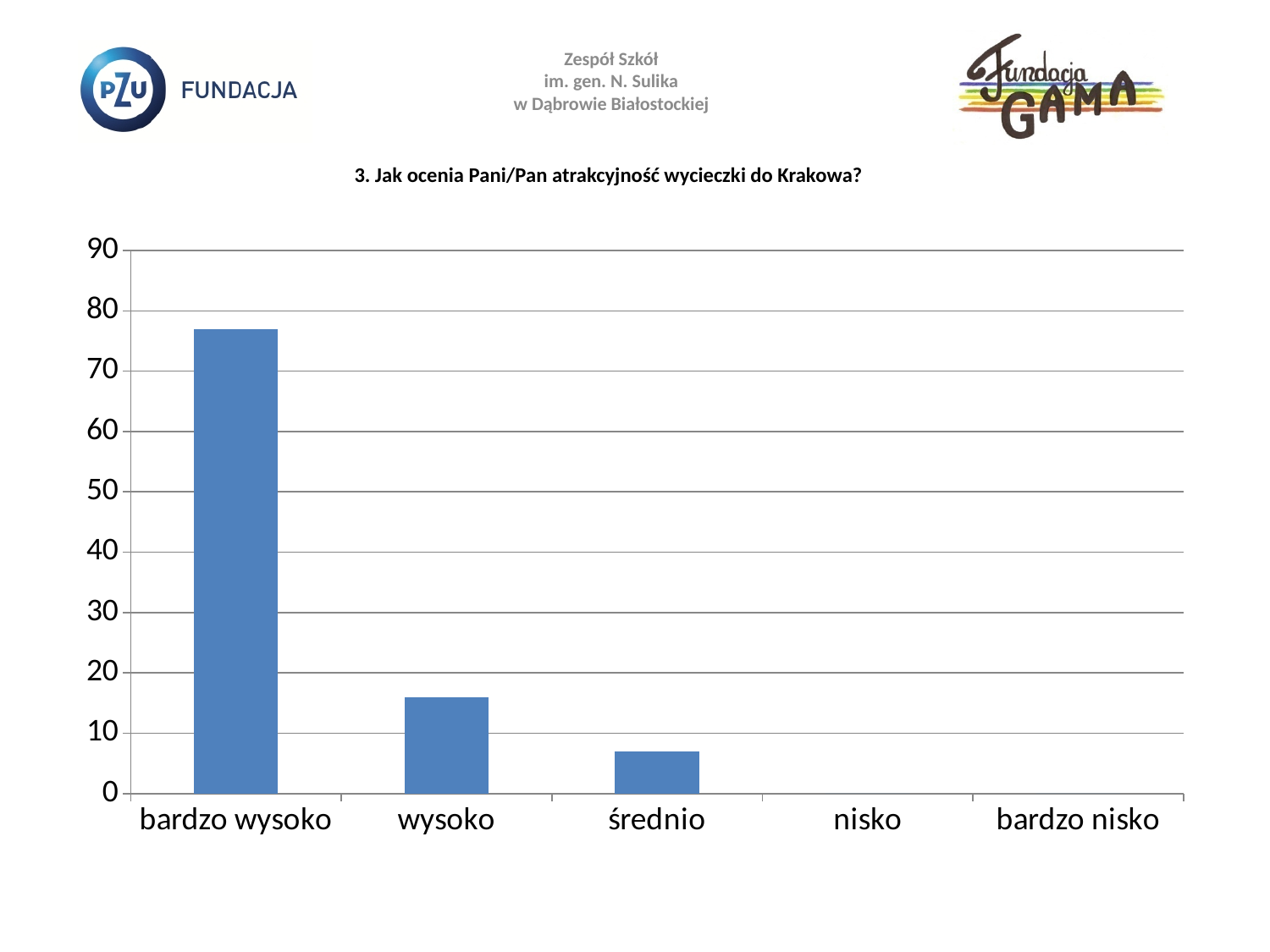
What is the title of the chart? 3. Jak ocenia Pani/Pan atrakcyjność wycieczki do Krakowa? How many categories are shown on the x axis? 5 What kind of chart is shown on the slide? bar chart Is the value for średnio greater or less than 10? less Is the value for wysoko greater or less than 10? greater Is the value for bardzo wysoko greater or less than 80? less Do the values rise or fall moving from bardzo wysoko to bardzo nisko along the x axis? fall Which is larger, the value for wysoko or the value for średnio? wysoko Which category has the highest value? bardzo wysoko What is the value for nisko? 0